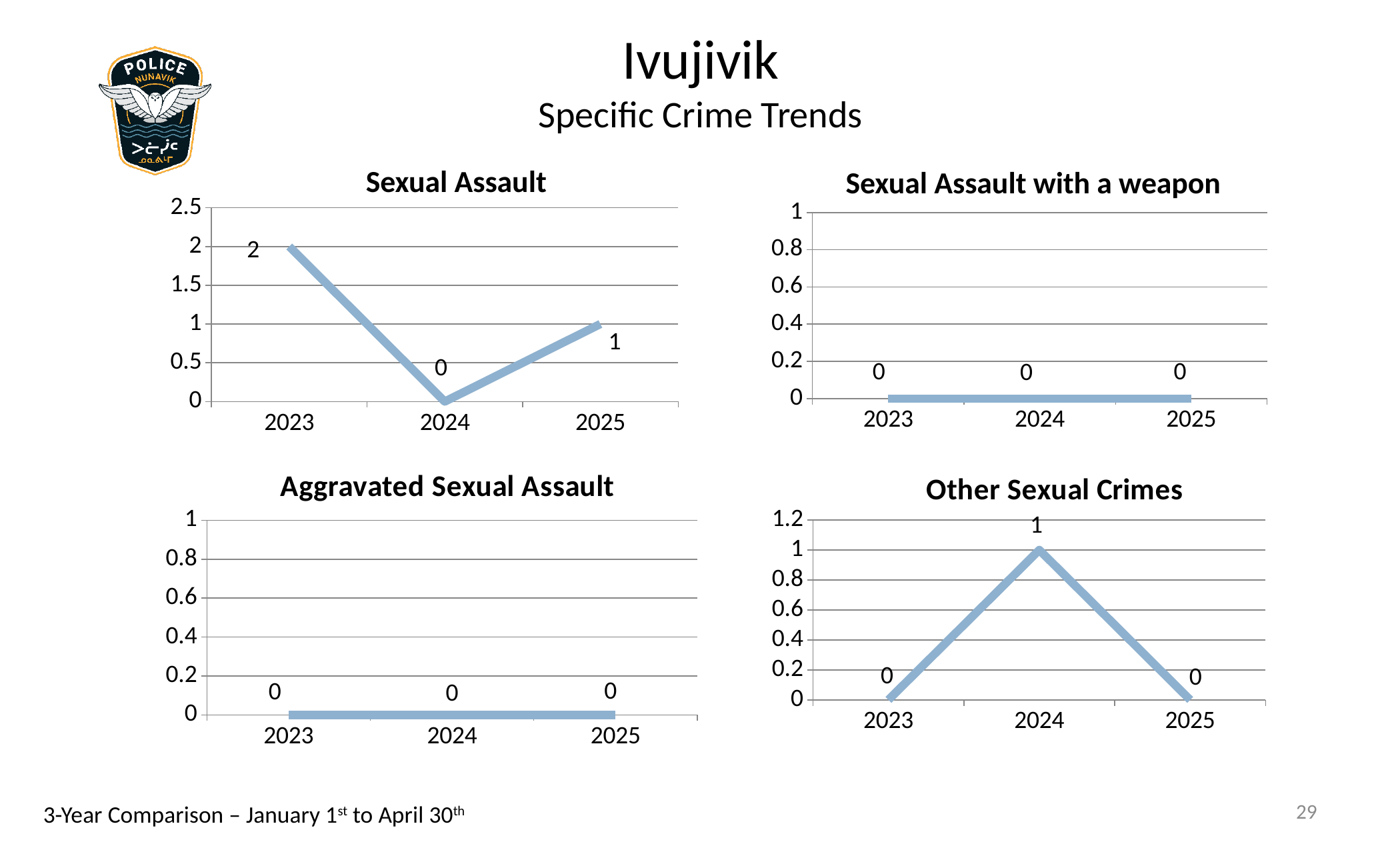
In the Sexual Assault chart, which year has the highest value? 2023 How many years are plotted in the Other Sexual Crimes chart? 3 In the Aggravated Sexual Assault chart, what is the value for 2023? 0 In the Sexual Assault chart, what is the difference between the 2023 and 2025 values? 1 In the Sexual Assault chart, what is the value for 2023? 2 In the Sexual Assault chart, which year has the lowest value? 2024 In the Sexual Assault with a weapon chart, what is the value for 2025? 0 In the Sexual Assault chart, is the value for 2023 larger or smaller than the value for 2025? larger In the Sexual Assault chart, what is the value for 2025? 1 In the Other Sexual Crimes chart, which year has the highest value? 2024 In the Other Sexual Crimes chart, what is the value for 2024? 1 What kind of chart is the Sexual Assault chart? line chart